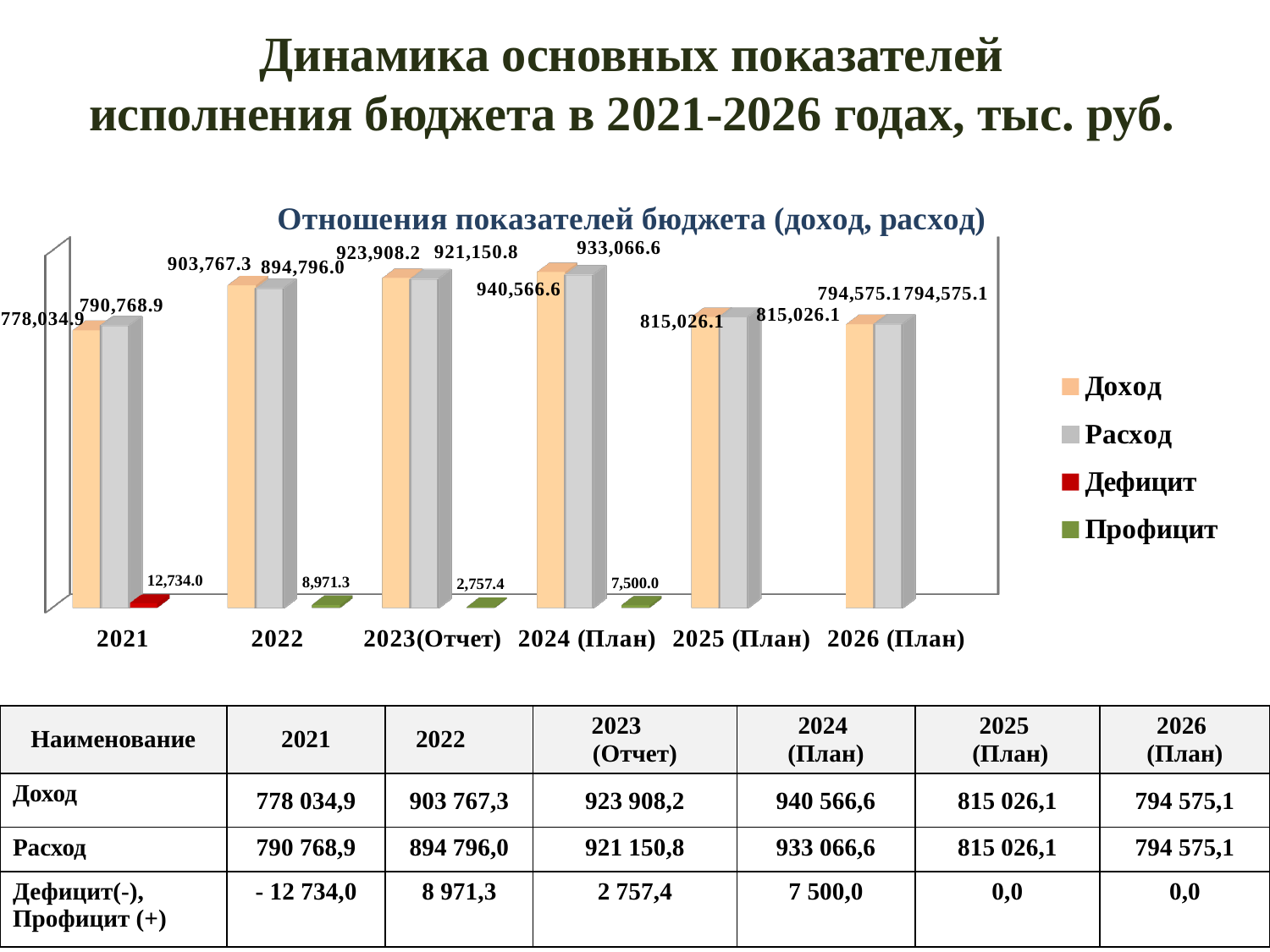
What type of chart is shown on the slide? bar chart What is the value of Профицит for 2022 in the chart? 8,971.3 For 2022, which is larger in the chart: Доход or Расход? Доход What is the title of the chart? Отношения показателей бюджета (доход, расход) Which year has the highest Доход value in the chart? 2024 (План) Which year has the lowest Доход value in the chart? 2021 How many series does the chart legend list? 4 What is the value of Доход for 2021 in the chart? 778,034.9 How many year categories are shown on the x axis of the chart? 6 What is the difference between Доход and Расход for 2024 (План) in the chart? 7,500.0 Does the Доход series rise or fall from 2024 (План) to 2026 (План) in the chart? fall What is the value of Расход for 2023(Отчет) in the chart? 921,150.8